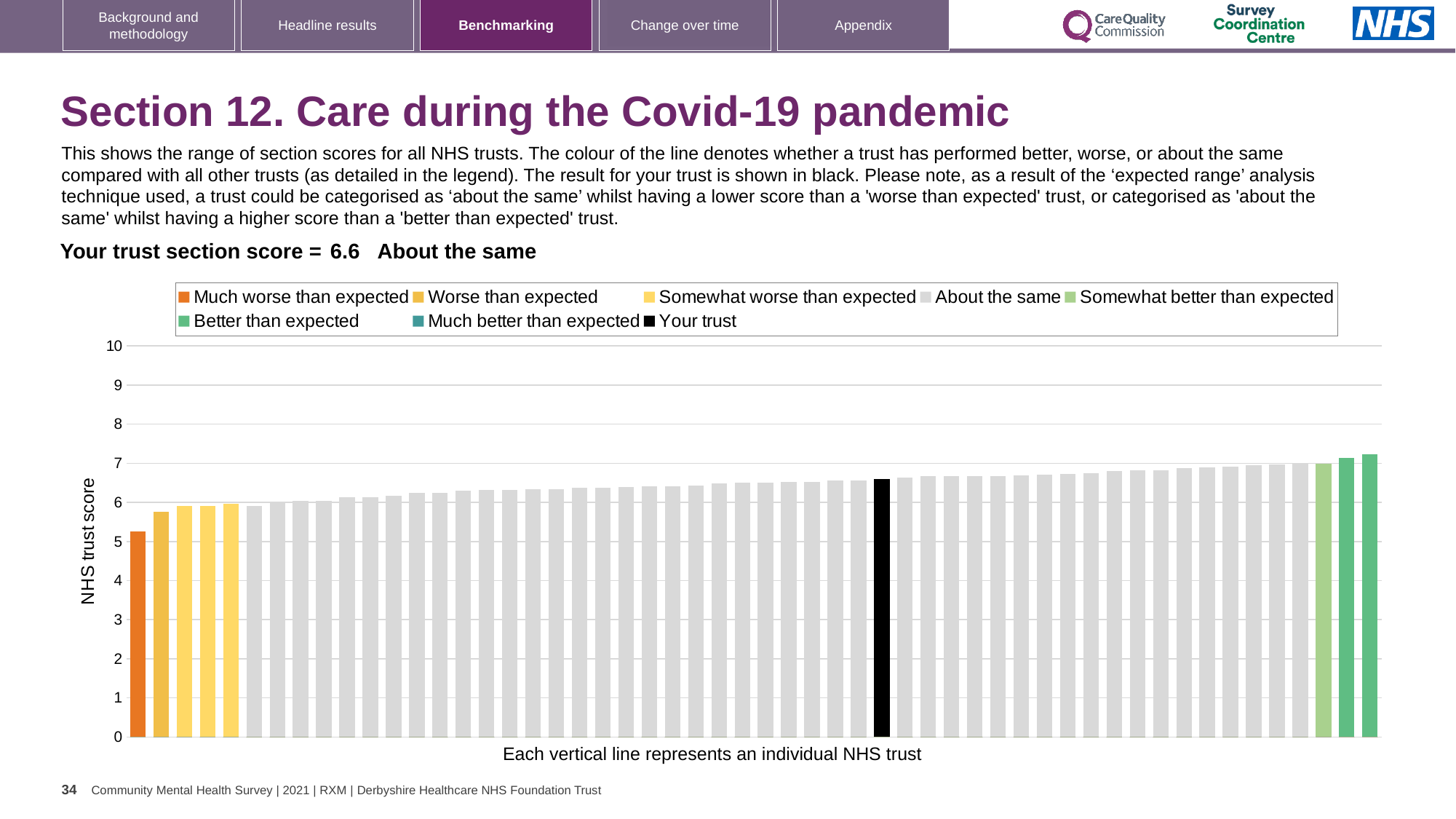
What is the label on the vertical axis of the chart? NHS trust score Do the bar values rise or fall from left to right along the x axis? Rise Which legend category does the shortest bar belong to? Much worse than expected Is the value of the 'Your trust' bar greater or less than 5? greater Is the value of the 'Much worse than expected' bar greater or less than 6? less Is the value of the tallest bar greater or less than 6? greater Which legend category does the tallest bar belong to? Better than expected How many bars are coloured as 'Better than expected'? 2 How many entries does the chart legend list? 8 What kind of chart is shown on the slide? Bar chart What is the section score for 'Your trust' shown on the slide? 6.6 How many bars are coloured as 'Much worse than expected'? 1